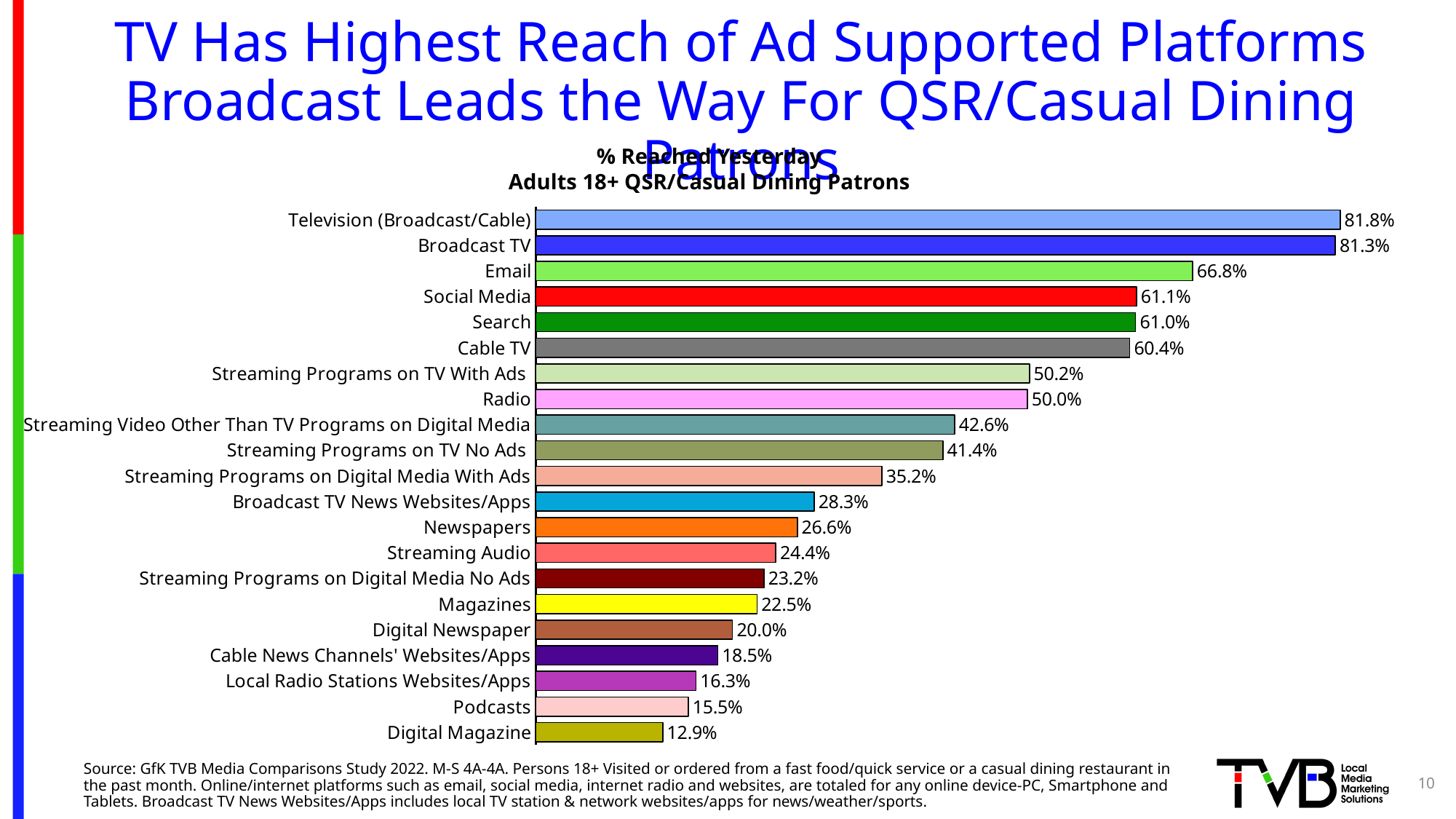
How many categories are plotted on the chart? 21 What is the difference in percentage points between Email and Cable TV? 6.4 What kind of chart is shown on the slide? Bar chart What is the subtitle printed above the chart? % Reached Yesterday Adults 18+ QSR/Casual Dining Patrons Which is larger, the value for Streaming Audio or the value for Digital Newspaper? Streaming Audio What is the value shown for Radio? 50.0% What is the value shown for Broadcast TV News Websites/Apps? 28.3% Which category has the highest value on the chart? Television (Broadcast/Cable) What is the value shown for Podcasts? 15.5% What is the difference in percentage points between Newspapers and Magazines? 4.1 What percentage of Adults 18+ QSR/Casual Dining Patrons were reached yesterday by Email? 66.8% Which category has the lowest value on the chart? Digital Magazine